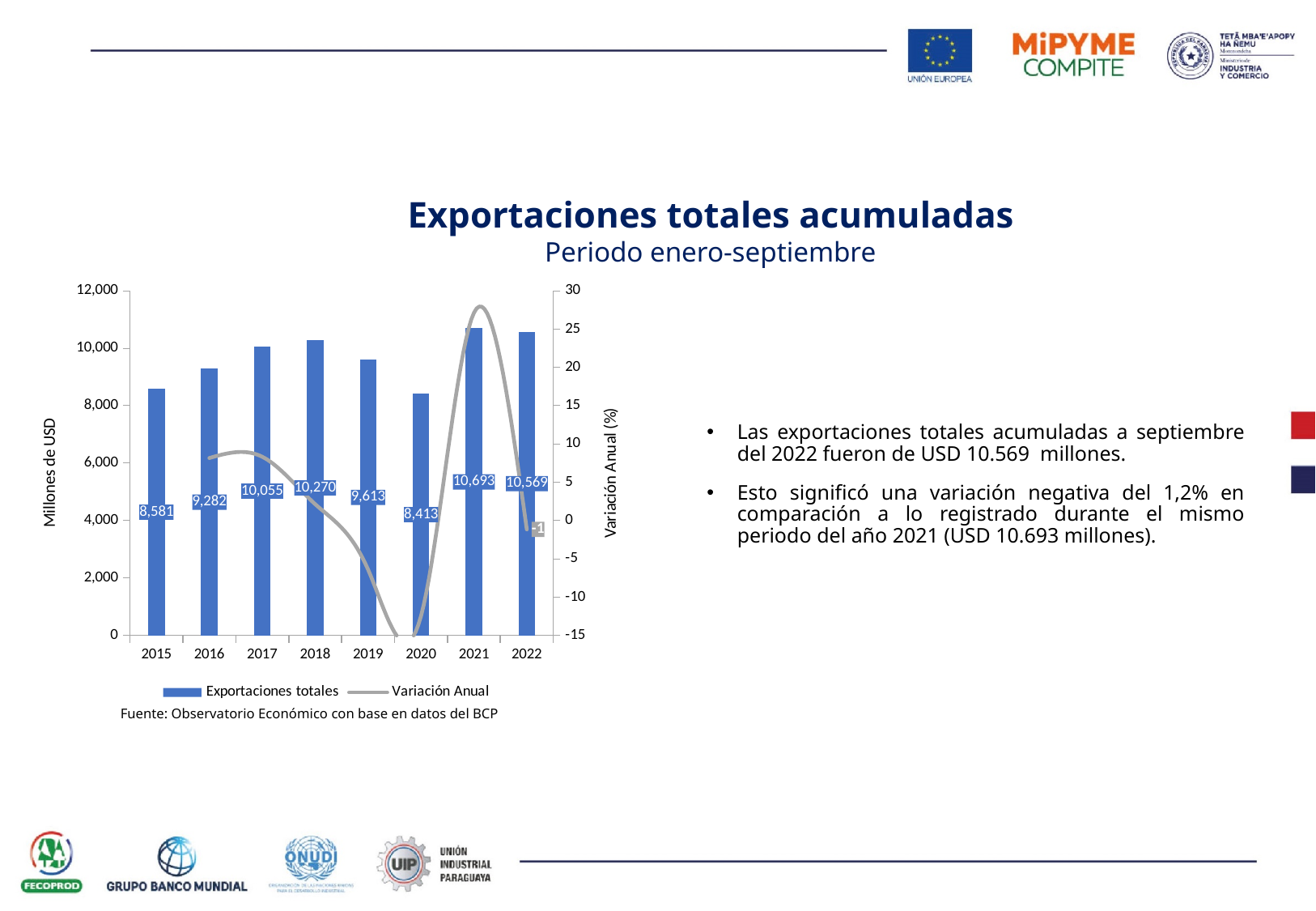
Which year has the highest value of Exportaciones totales? 2021 How many years are shown on the x axis? 8 What is the label of the left vertical axis? Millones de USD Is the Variación Anual value for 2020 greater or less than -10? less Which is larger, Exportaciones totales in 2017 or in 2019? 2017 Which year has the lowest value of Exportaciones totales? 2020 What is the difference between Exportaciones totales in 2021 and 2022? 124 Do the Exportaciones totales values rise or fall from 2015 to 2018? rise What is the value of Exportaciones totales for 2018? 10,270 What is the value of Exportaciones totales for 2022? 10,569 What is the value of Exportaciones totales for 2020? 8,413 How many series does the legend list? 2